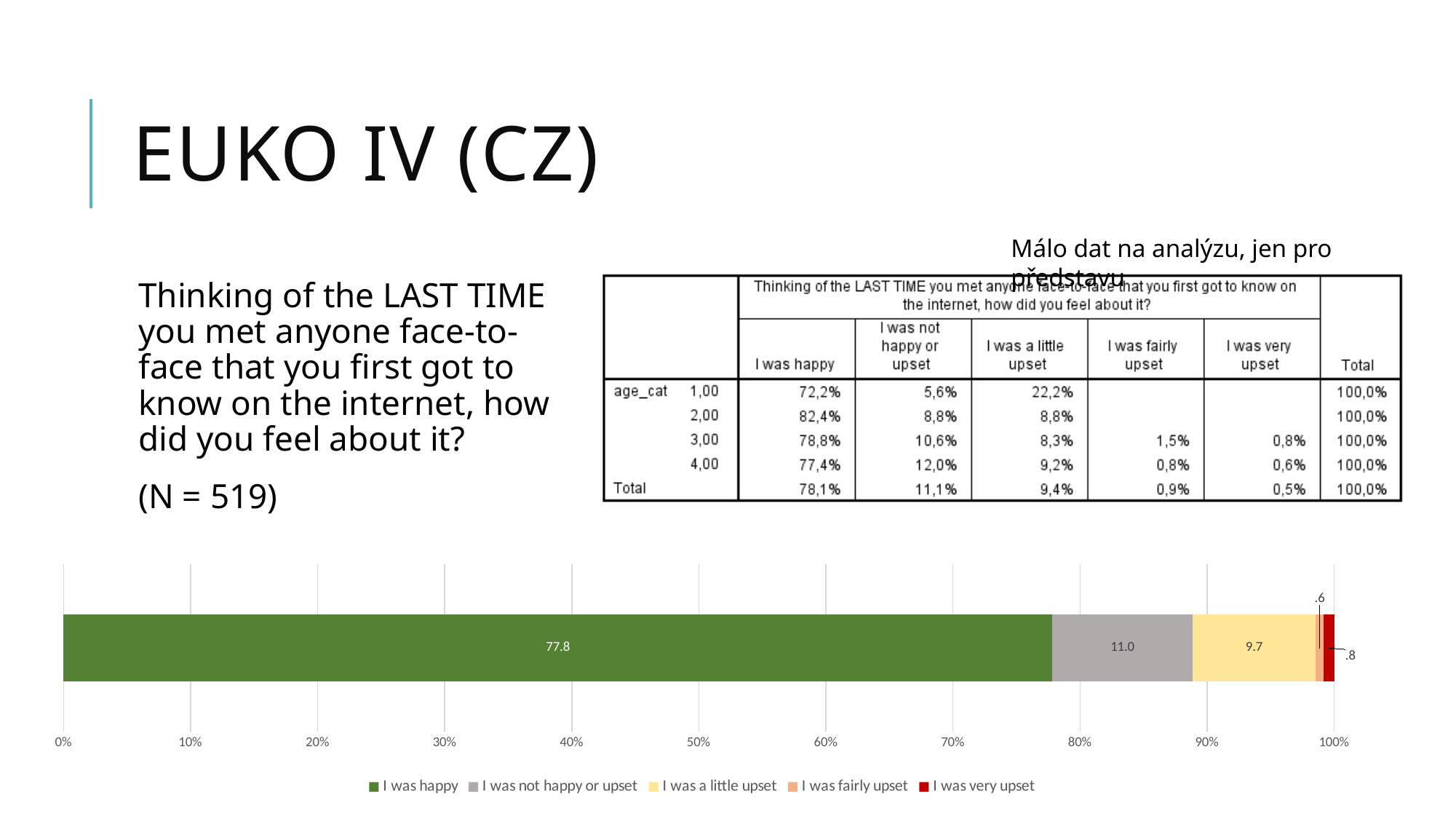
Which series has the largest segment in the bar chart? I was happy How many bars does the bar chart contain? 1 In the bar chart, which is larger: 'I was not happy or upset' or 'I was a little upset'? I was not happy or upset What is the value of the 'I was happy' segment in the bar chart? 77.8 What is the value of the 'I was a little upset' segment in the bar chart? 9.7 What is the difference between the 'I was not happy or upset' and 'I was a little upset' values in the bar chart? 1.3 What colour represents 'I was very upset' in the bar chart legend? Red What is the difference between the 'I was happy' and 'I was not happy or upset' values in the bar chart? 66.8 How many series does the legend of the bar chart list? 5 What is the value of the 'I was not happy or upset' segment in the bar chart? 11.0 Is the value for 'I was happy' in the bar chart greater or less than 70%? greater What kind of chart is shown at the bottom of the slide? Stacked bar chart